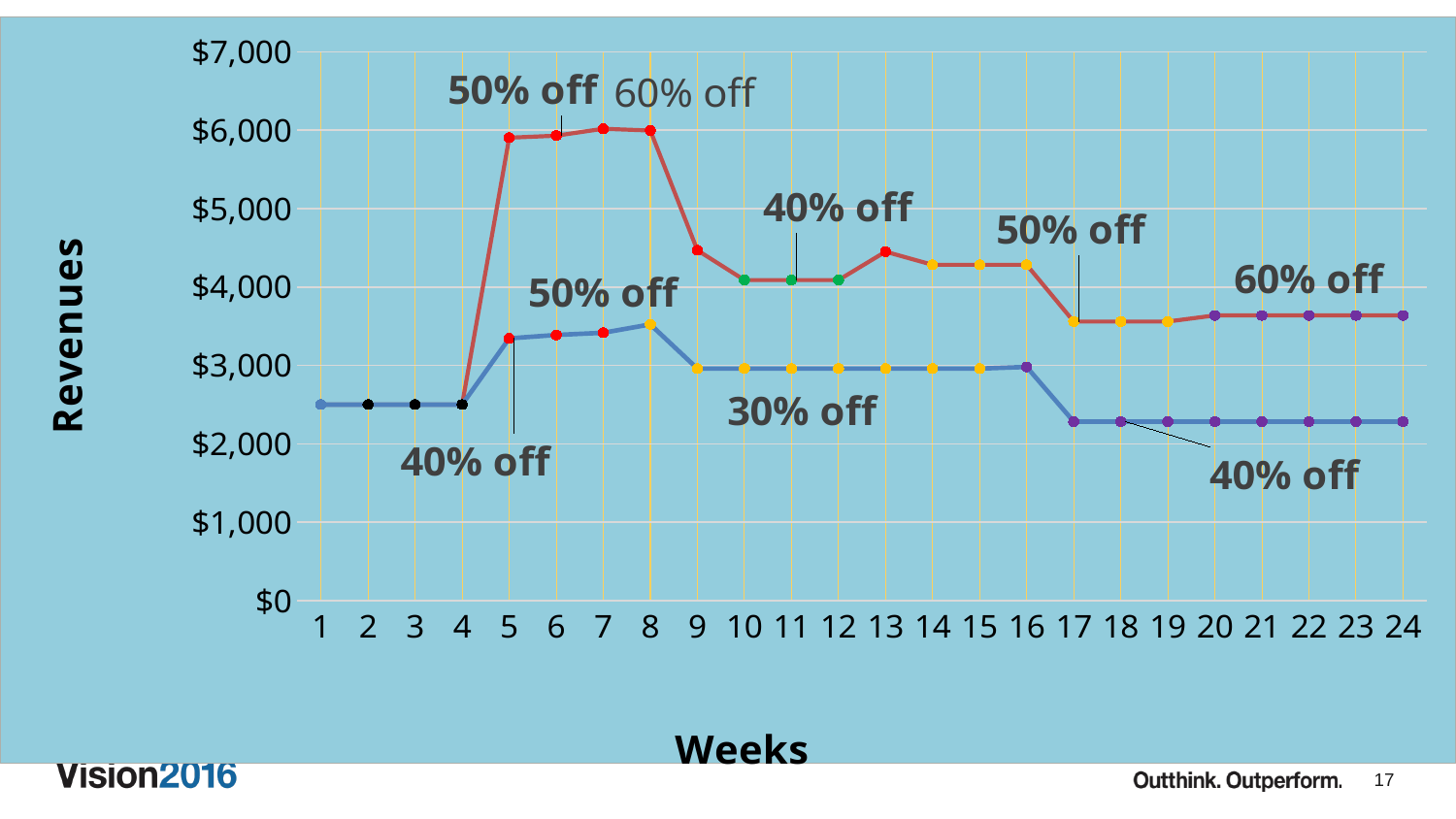
Is the value of the blue line at week 1 greater or less than $2,000? greater What is the title of the horizontal axis? Weeks What kind of chart is shown on the slide? line chart At week 6, which line has the higher revenue, the red line or the blue line? the red line Is the value of the blue line at week 17 greater or less than $3,000? less Does the red line rise or fall between week 8 and week 9? fall Is the value of the blue line at week 8 greater or less than $3,000? greater How many weeks are plotted along the x axis? 24 What is the title of the vertical axis? Revenues